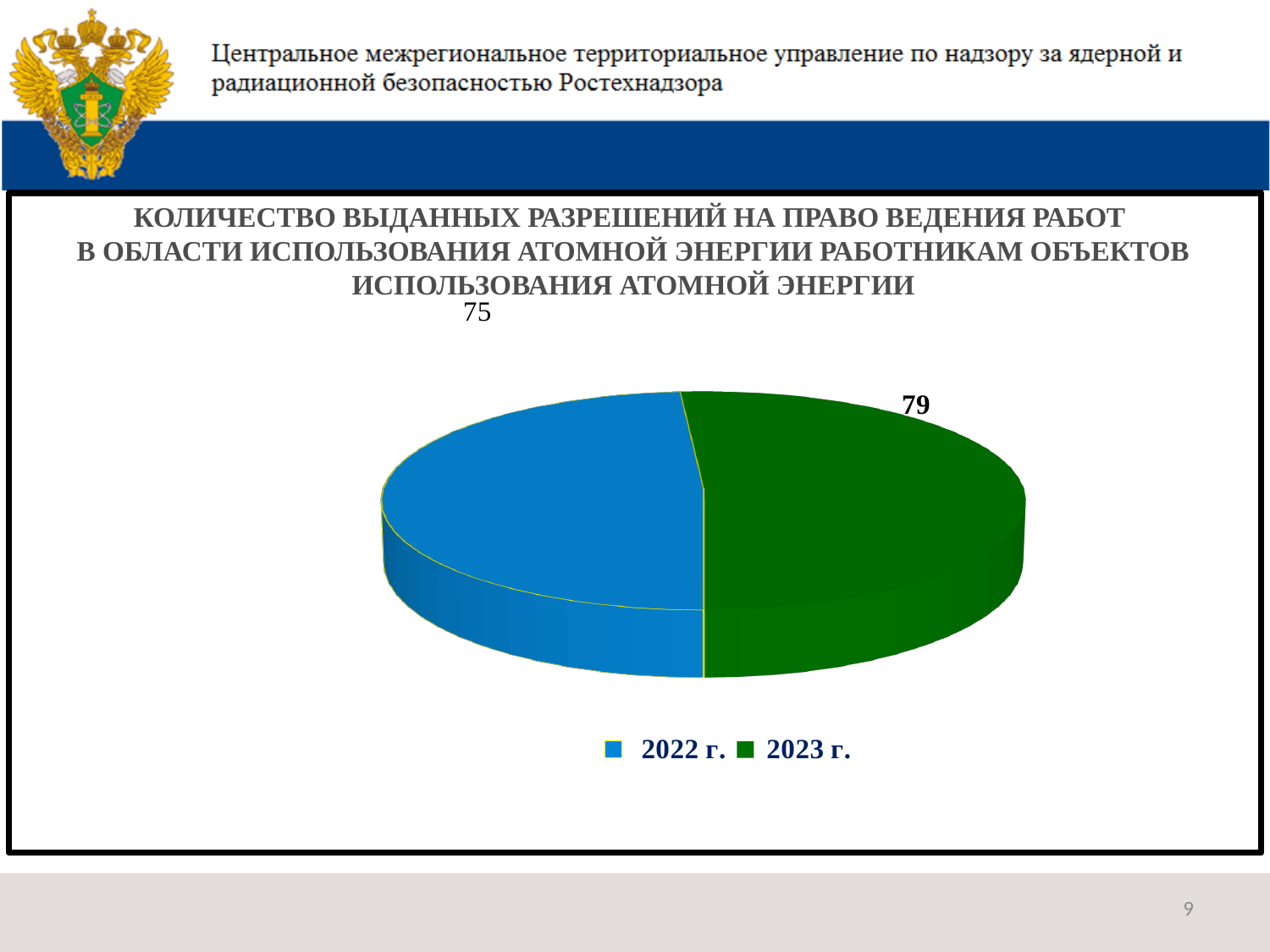
Which colour represents 2022 г. in the pie chart? Blue What is the total of the two values shown in the pie chart? 154 What is the value for 2023 г. in the pie chart? 79 Which year has the smaller slice in the pie chart? 2022 г. Which colour represents 2023 г. in the pie chart? Green Is the value for 2023 г. larger or smaller than the value for 2022 г.? Larger What is the value for 2022 г. in the pie chart? 75 How many entries does the legend list? 2 Which year has the larger slice in the pie chart? 2023 г. What type of chart is shown on the slide? Pie chart What is the difference between the values for 2023 г. and 2022 г.? 4 How many slices does the pie chart have? 2